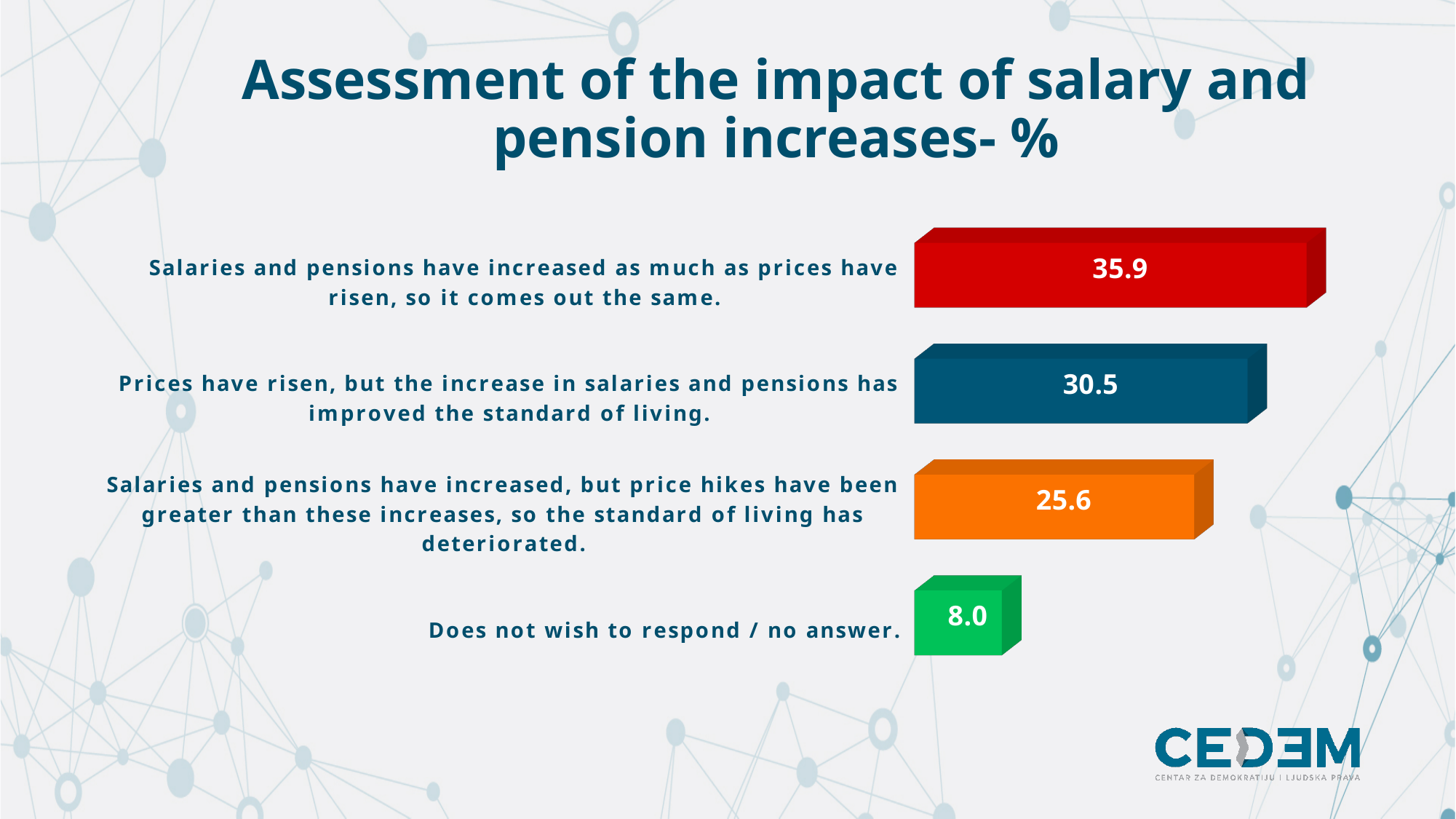
Which category has the lowest value? Does not wish to respond / no answer. What is the value for "Prices have risen, but the increase in salaries and pensions has improved the standard of living."? 30.5 What is the value for "Does not wish to respond / no answer."? 8.0 What is the value for "Salaries and pensions have increased, but price hikes have been greater than these increases, so the standard of living has deteriorated."? 25.6 How many categories are shown in the chart? 4 What is the difference between the value for "Prices have risen, but the increase in salaries and pensions has improved the standard of living." and the value for "Does not wish to respond / no answer."? 22.5 What is the difference between the value for "Salaries and pensions have increased as much as prices have risen, so it comes out the same." and the value for "Prices have risen, but the increase in salaries and pensions has improved the standard of living."? 5.4 What kind of chart is shown on the slide? Bar chart Which category has the highest value? Salaries and pensions have increased as much as prices have risen, so it comes out the same. What is the title of the chart? Assessment of the impact of salary and pension increases- % What is the value for "Salaries and pensions have increased as much as prices have risen, so it comes out the same."? 35.9 Which is larger: the value for "Prices have risen, but the increase in salaries and pensions has improved the standard of living." or the value for "Salaries and pensions have increased, but price hikes have been greater than these increases, so the standard of living has deteriorated."? Prices have risen, but the increase in salaries and pensions has improved the standard of living.